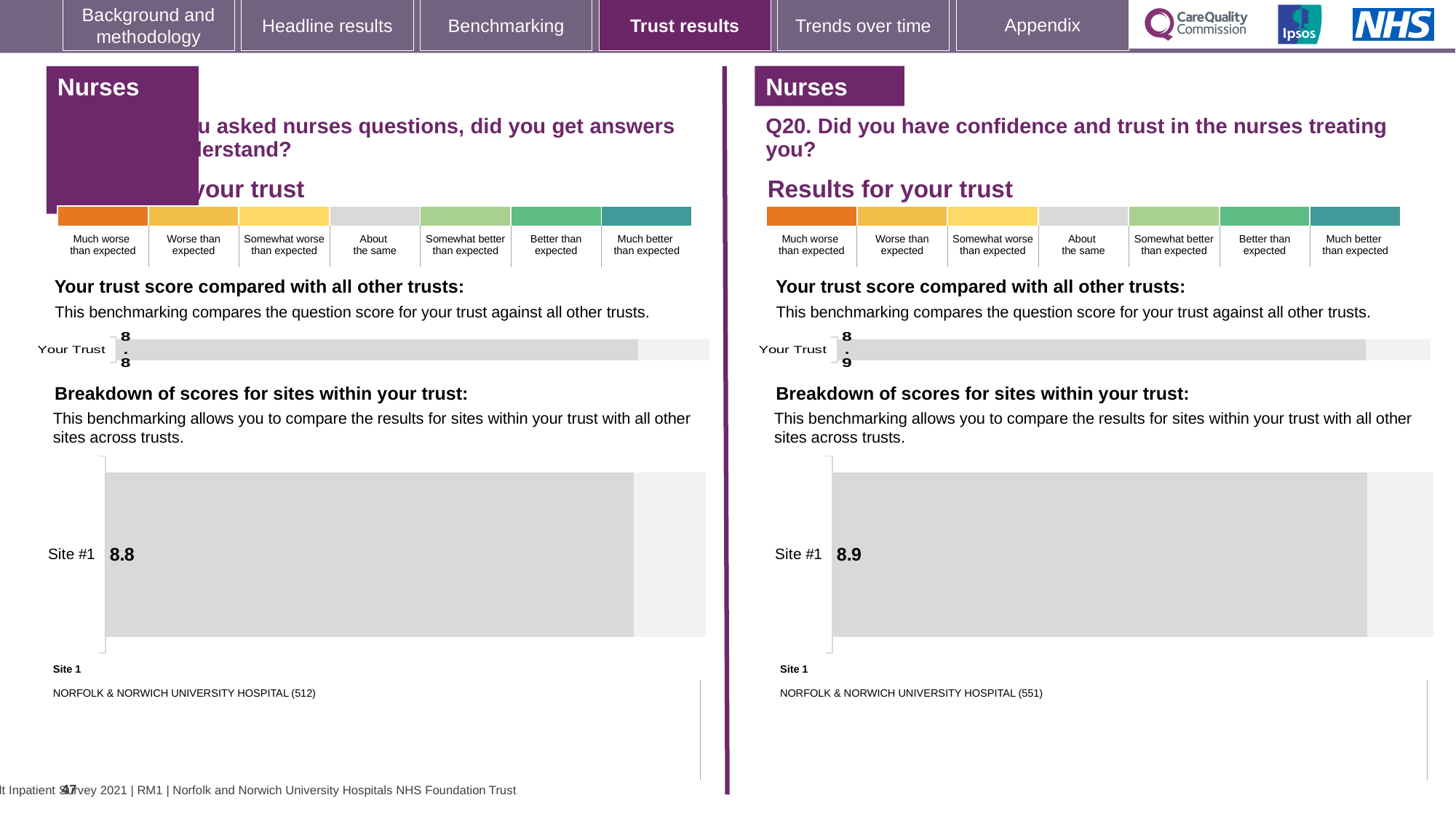
How many sites are shown in the breakdown of scores chart on the left panel? 1 Which is larger: the Site #1 score on the left panel or the Site #1 score on the right panel (Q20)? Right panel (Q20), 8.9 On the right panel (Q20), what is the name of Site 1 listed below the chart? NORFOLK & NORWICH UNIVERSITY HOSPITAL (551) What kind of chart is used to show the Site #1 score on the right panel (Q20)? Bar chart What is the difference between the Site #1 score on the right panel (Q20) and the Site #1 score on the left panel? 0.1 On the right panel (Q20), what is the score shown for Site #1 in the breakdown of scores for sites within your trust? 8.9 On the left panel, what is the 'Your Trust' score in the chart comparing the trust score with all other trusts? 8.8 On the right panel (Q20), is the 'Your Trust' score the same as the Site #1 score? Yes, both 8.9 On the right panel (Q20), what is the 'Your Trust' score in the chart comparing the trust score with all other trusts? 8.9 How many sites are shown in the breakdown of scores chart on the right panel (Q20)? 1 On the left panel, what is the name of Site 1 listed below the chart? NORFOLK & NORWICH UNIVERSITY HOSPITAL (512) On the left panel, what is the score shown for Site #1 in the breakdown of scores for sites within your trust? 8.8